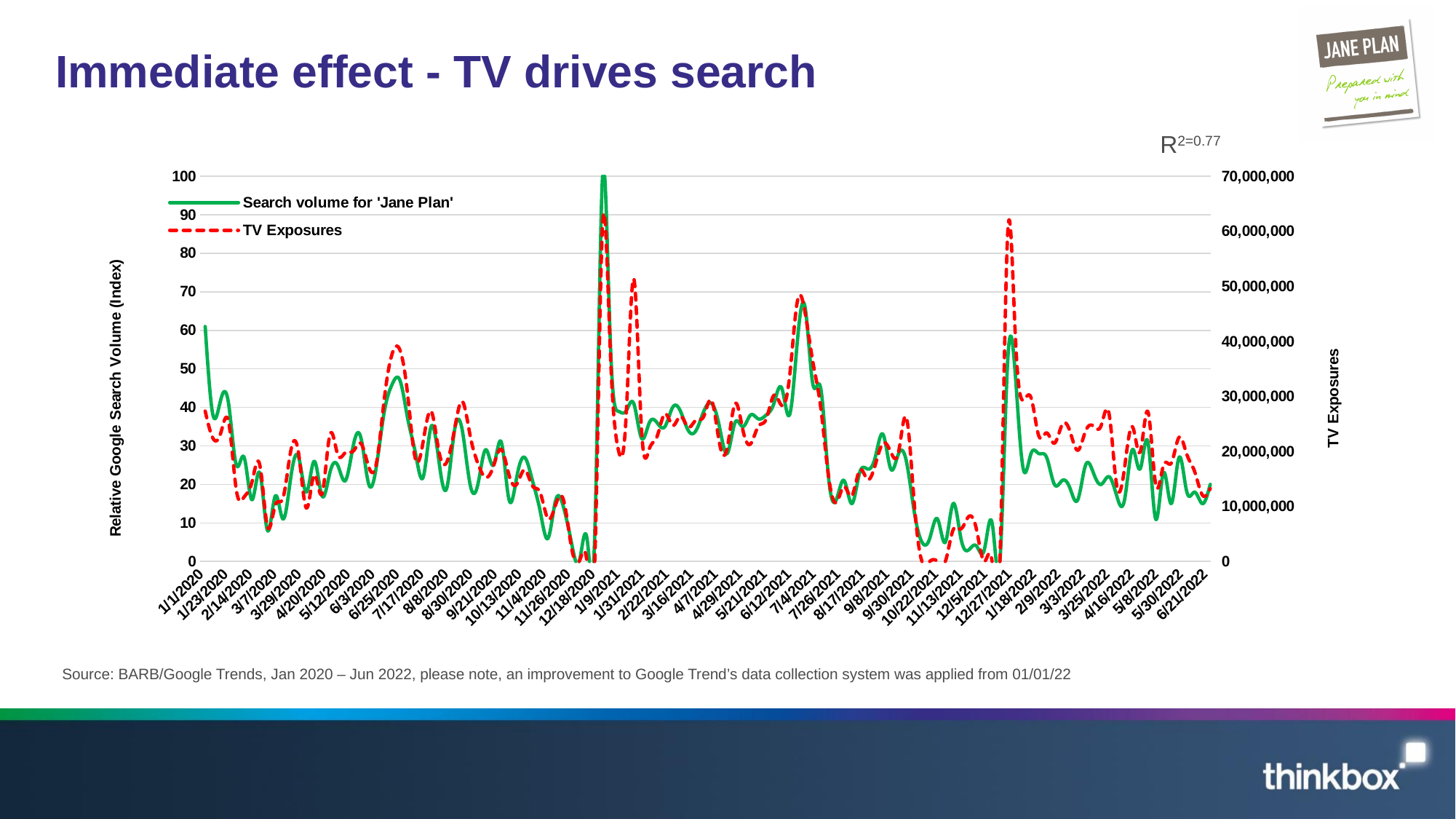
Is the TV Exposures value around 11/13/2021 greater or less than 10,000,000? less Is the peak TV Exposures value near 12/27/2021 greater or less than 50,000,000? greater What R-squared value is shown above the chart? 0.77 Is the search volume for 'Jane Plan' around 10/22/2021 greater or less than 20? less What are the two series named in the chart's legend? Search volume for 'Jane Plan' and TV Exposures What kind of chart is shown on the slide? Line chart How many series does the chart's legend list? 2 Does the search volume for 'Jane Plan' rise or fall between 1/1/2020 and 3/7/2020? fall Which series is drawn as a red dashed line? TV Exposures What is the highest value reached by the 'Search volume for Jane Plan' line? 100